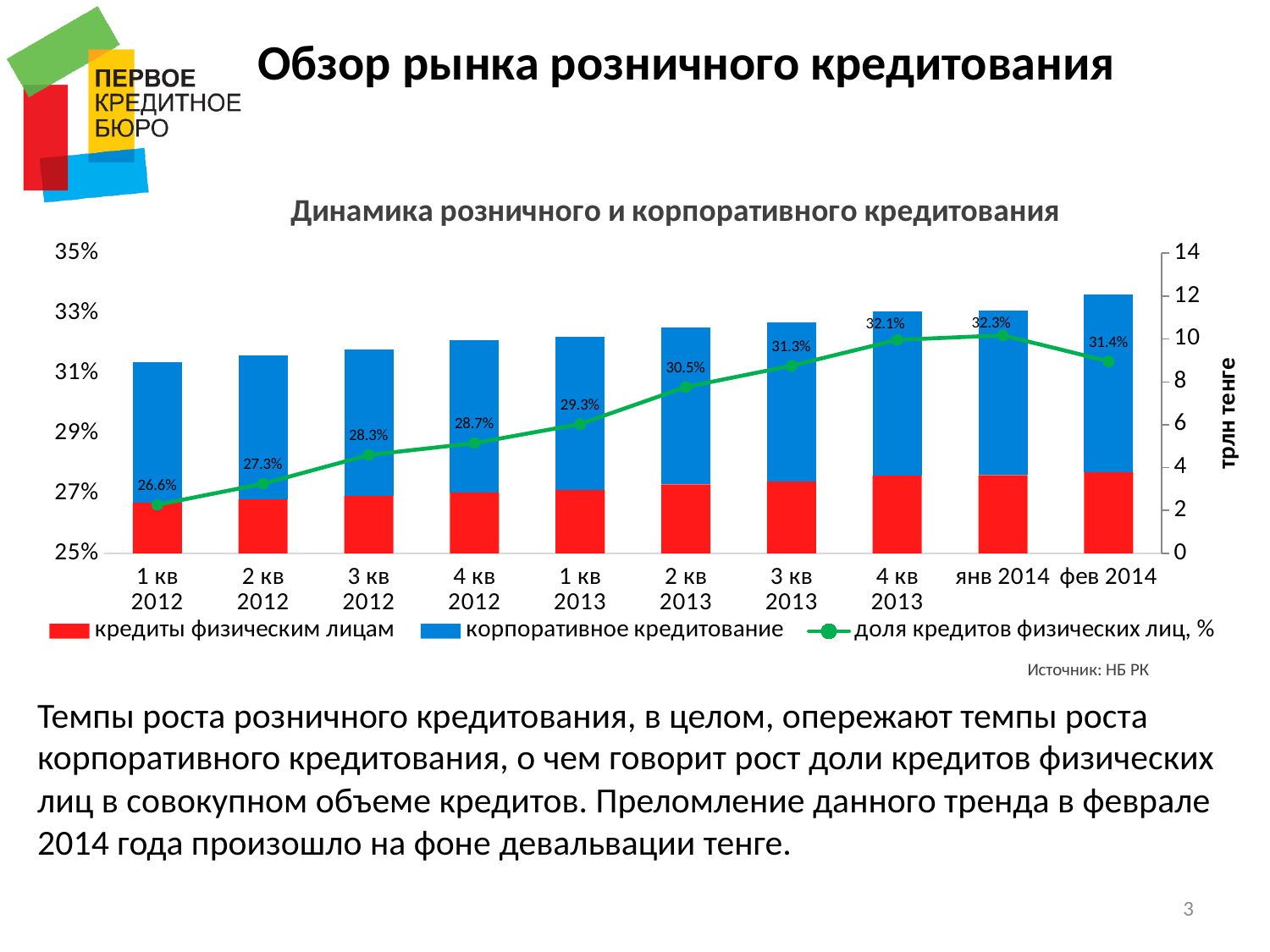
What is the value of 'доля кредитов физических лиц, %' for 4 кв 2013? 32.1% What is the value of the line series 'доля кредитов физических лиц, %' for 1 кв 2012? 26.6% Which is larger: 'доля кредитов физических лиц, %' in 2 кв 2013 or in 3 кв 2012? 2 кв 2013 What is the value of 'доля кредитов физических лиц, %' for фев 2014? 31.4% What is the title of the chart? Динамика розничного и корпоративного кредитования Is the total height of the stacked bar for 1 кв 2012 greater or less than 10 трлн тенге? less In which period does 'доля кредитов физических лиц, %' reach its highest value? янв 2014 How many series does the legend list? 3 In which period is 'доля кредитов физических лиц, %' lowest? 1 кв 2012 What is the difference between 'доля кредитов физических лиц, %' in янв 2014 and in 1 кв 2012? 5.7% Is the total height of the stacked bar for фев 2014 greater or less than 10 трлн тенге? greater How many periods are shown on the x axis of the chart? 10